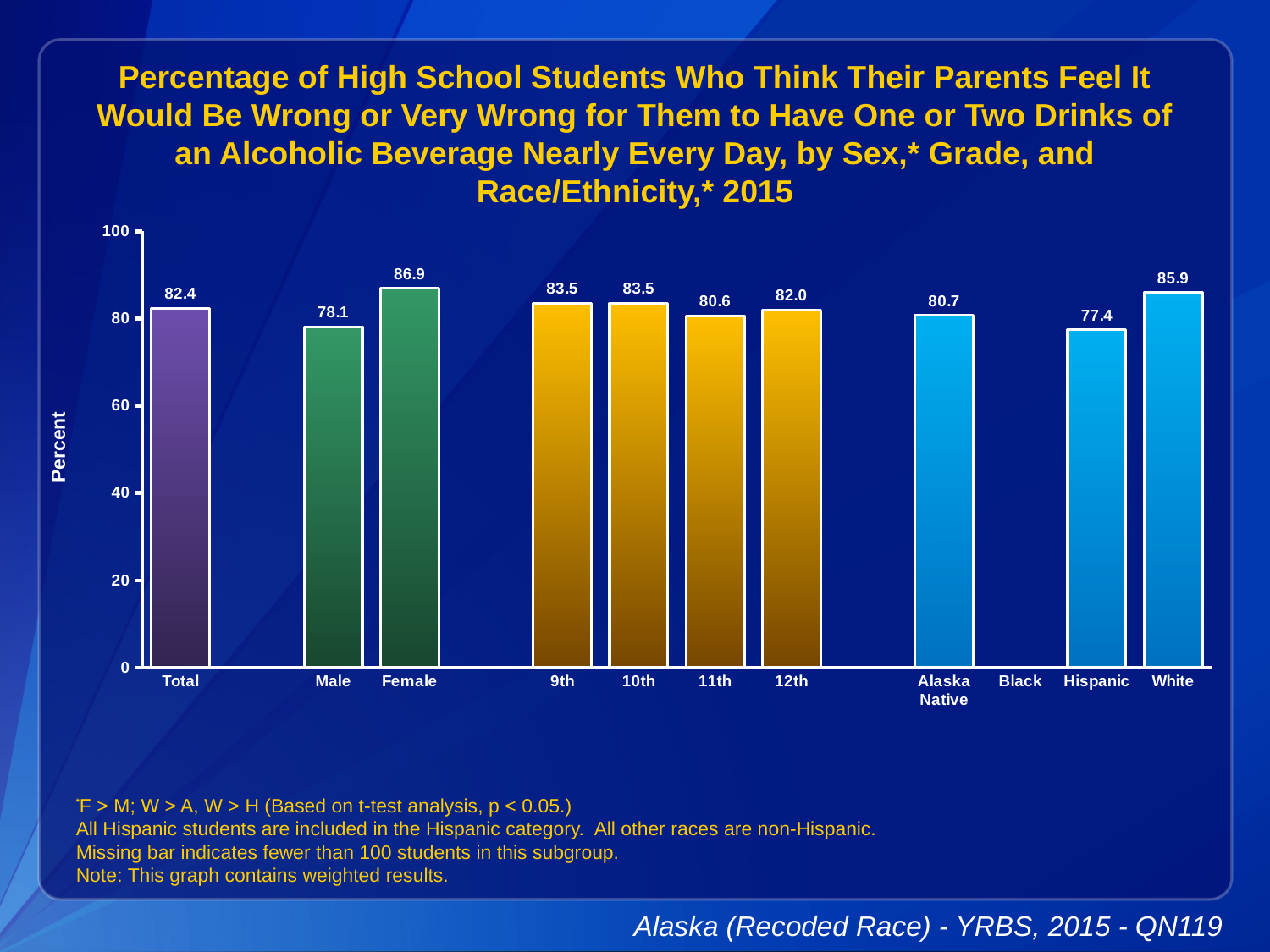
How many bars are plotted on the chart? 11 Which category on the x axis has no bar plotted? Black Which category has the highest value? Female What kind of chart is shown? bar chart Which is larger, the value for White or the value for Hispanic? White What is the value for Total? 82.4 What is the difference between the Female and Male values? 8.8 Which category has the lowest value among the bars shown? Hispanic What is the value for Female? 86.9 Is the value for 12th grade greater or less than 80? greater What is the value for 11th grade? 80.6 What is the value for Alaska Native? 80.7